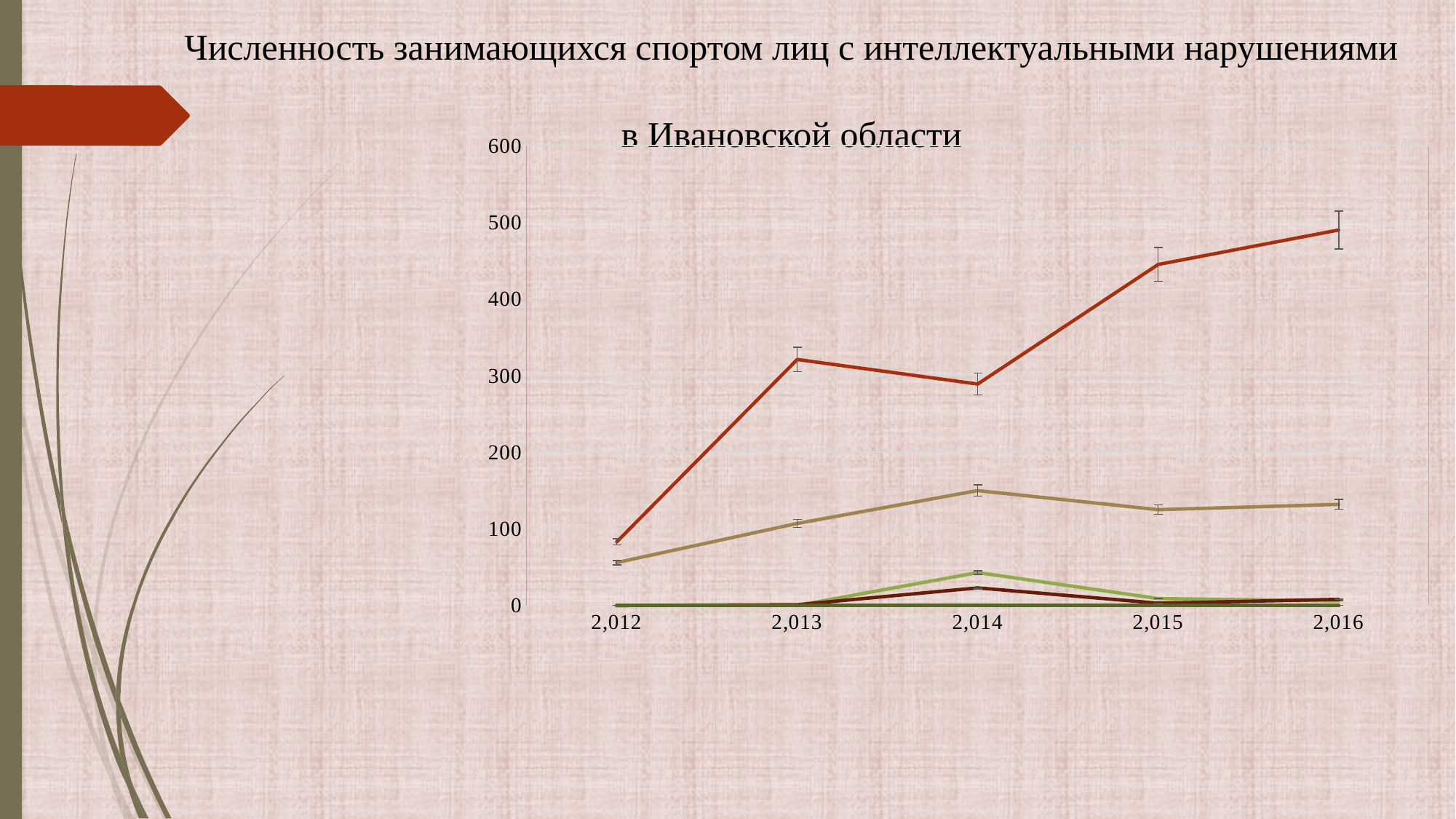
Is the value of the tan line for 2,012 greater or less than 100? less What kind of chart is shown on the slide? line chart In which year does the red line reach its highest value? 2,016 What is the first year shown on the x axis? 2,012 Is the value of the red line for 2,016 greater or less than 400? greater Is the value of the red line for 2,012 greater or less than 100? less How many years are shown along the x axis of the chart? 5 In which year does the red line have its lowest value? 2,012 What is the title of the chart? Численность занимающихся спортом лиц с интеллектуальными нарушениями в Ивановской области In 2,016, which line is higher, the red line or the tan line? the red line